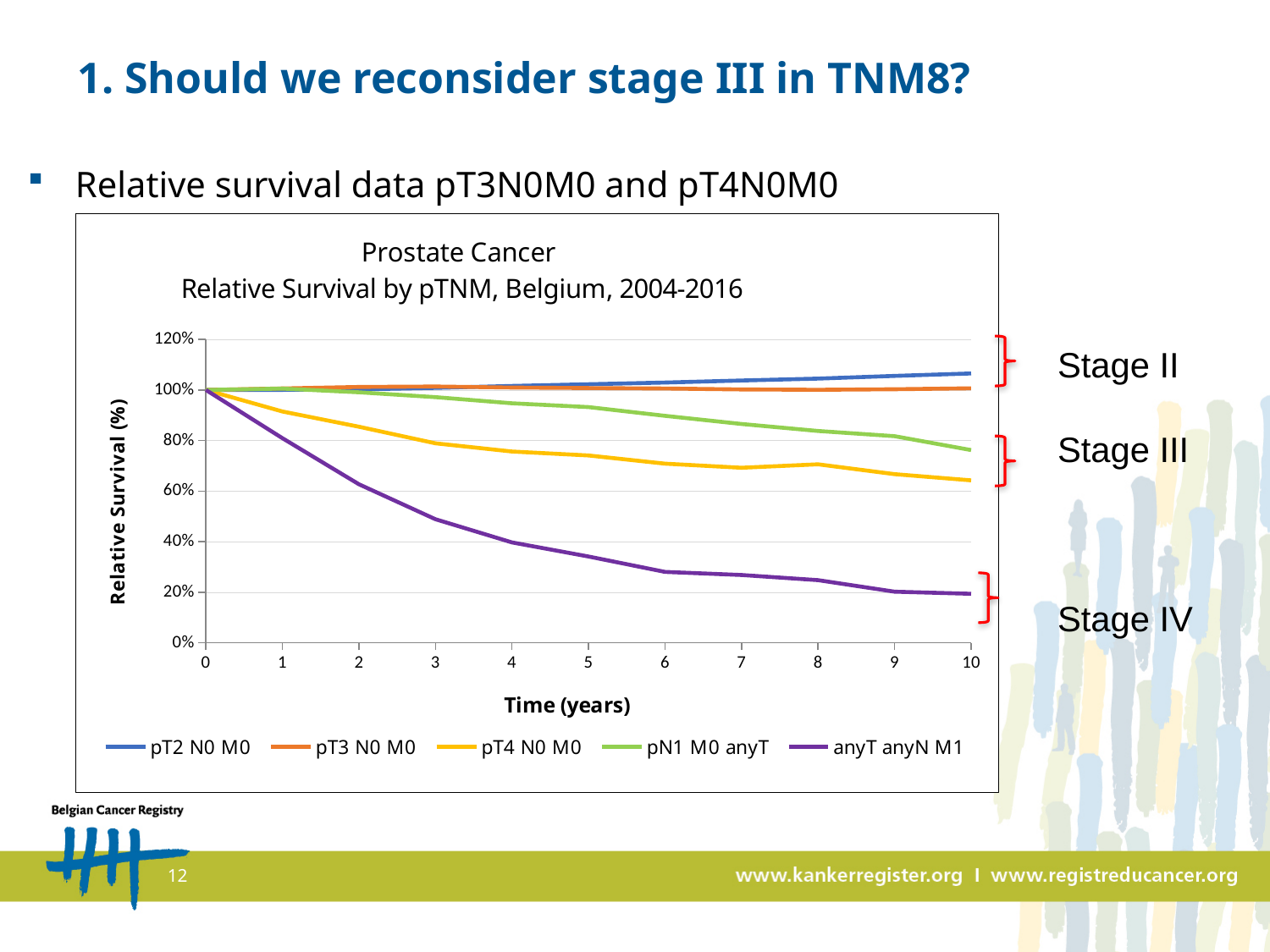
Is the relative survival for pT4 N0 M0 at 10 years greater or less than 60%? greater How many series does the legend list? 5 Is the relative survival for anyT anyN M1 at 5 years greater or less than 40%? less Does the relative survival for anyT anyN M1 rise or fall over time? fall Which stage label is bracketed next to the pT4 N0 M0 and pN1 M0 anyT lines? Stage III What kind of chart is shown on the slide? line chart At 5 years, which series has the higher relative survival, pT4 N0 M0 or pN1 M0 anyT? pN1 M0 anyT What is the relative survival for pT2 N0 M0 at time 0 years? 100% Which series has the lowest relative survival at 10 years? anyT anyN M1 Which series has the highest relative survival at 10 years? pT2 N0 M0 What is the label of the y axis? Relative Survival (%) Is the relative survival for pN1 M0 anyT at 10 years greater or less than 80%? less